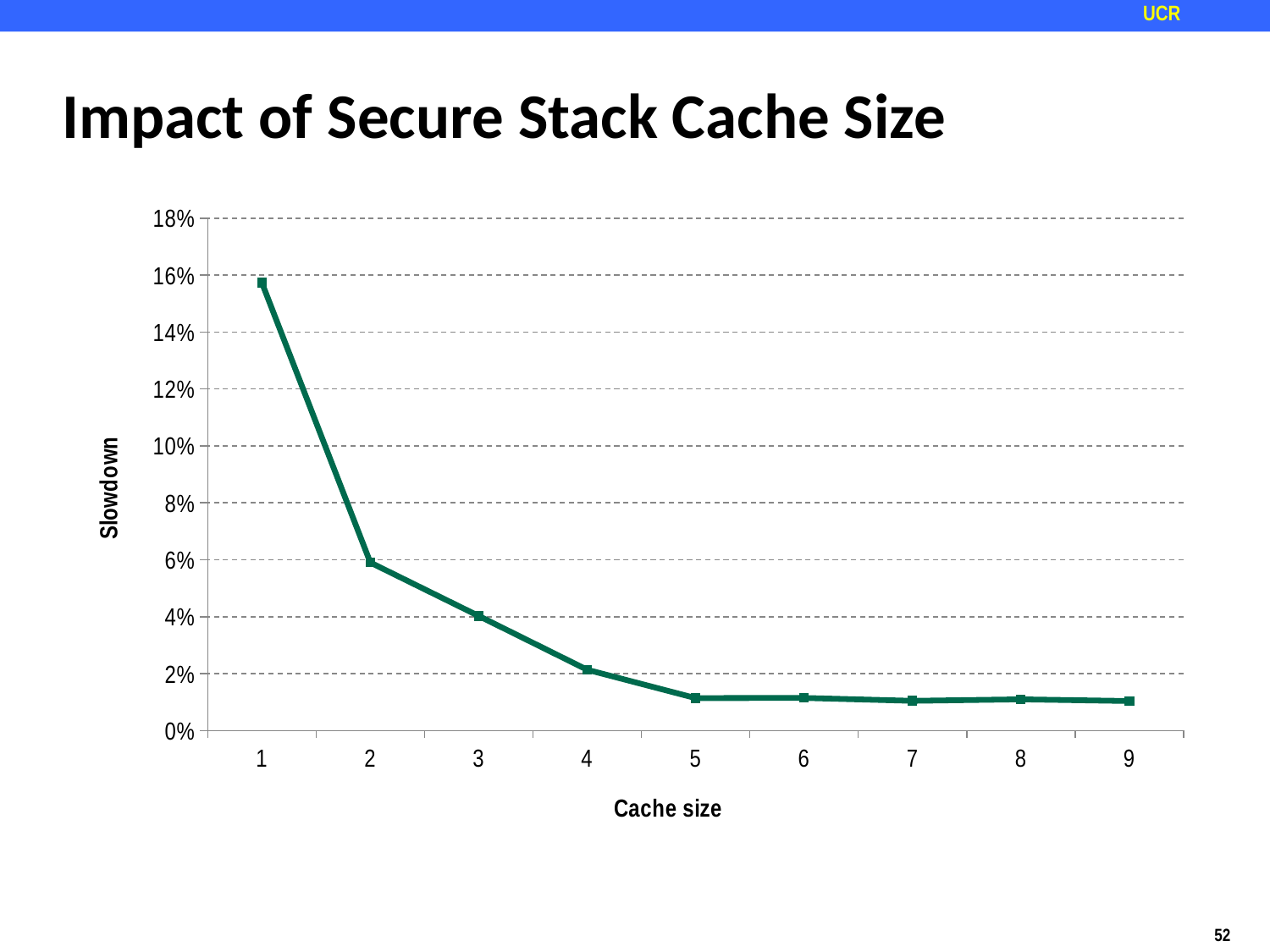
Is the slowdown for cache size 2 greater or less than 8%? less Does the slowdown rise or fall as cache size increases from 1 to 5? fall Is the slowdown for cache size 1 greater or less than 14%? greater Is the slowdown for cache size 9 greater or less than 2%? less Which has the larger slowdown, cache size 4 or cache size 1? cache size 1 Which cache size has the highest slowdown? 1 How many cache sizes are plotted on the x axis? 9 What is the label of the x axis? Cache size What is the label of the y axis? Slowdown Which has the larger slowdown, cache size 2 or cache size 3? cache size 2 What kind of chart is shown on the slide? line chart